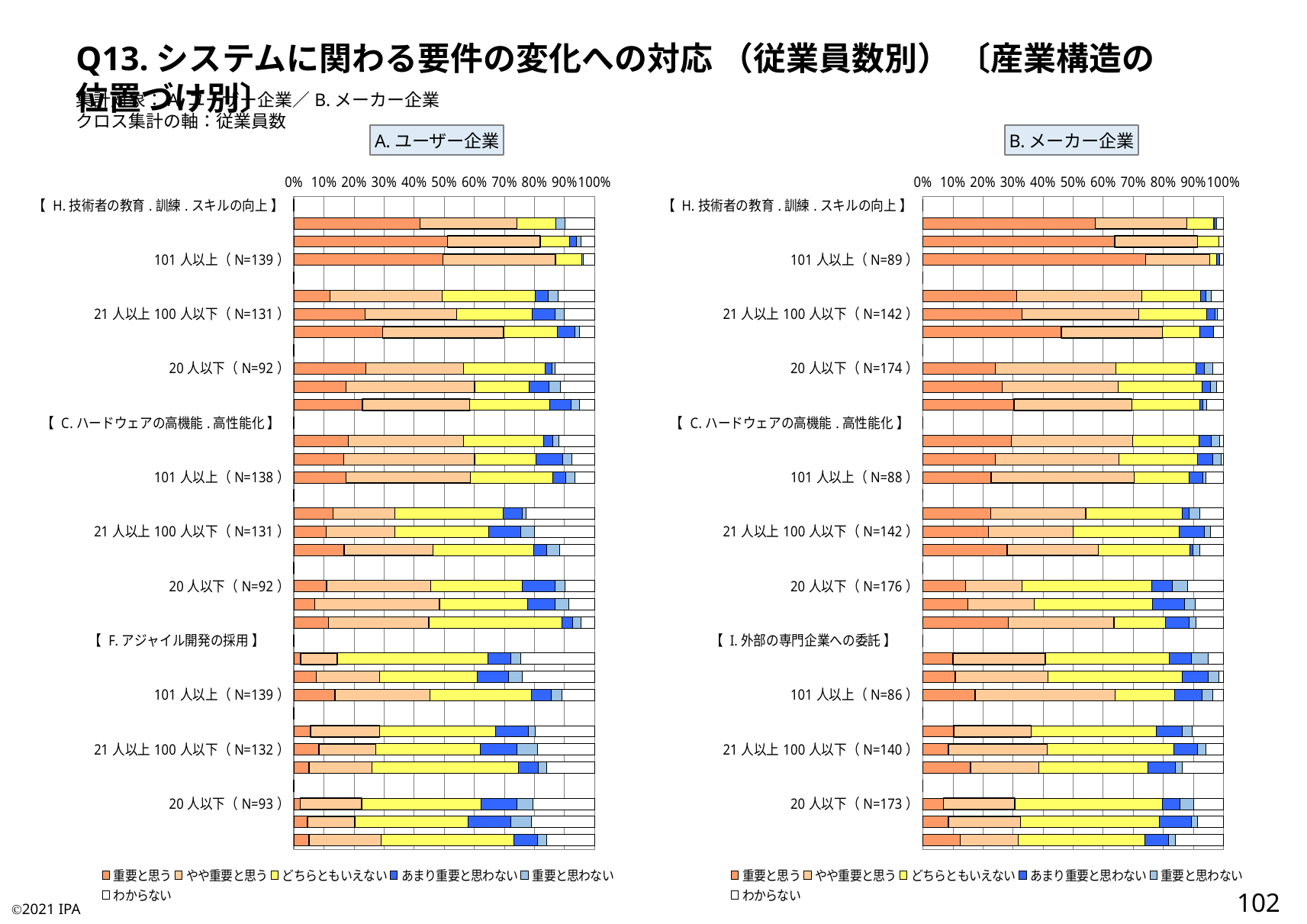
In the B. メーカー企業 chart, is the 重要と思う share for the bar labeled 20 人以下 (N=173) greater or less than 10%? less What is the first legend entry of the A. ユーザー企業 chart? 重要と思う What kind of chart is the A. ユーザー企業 chart on the left? Stacked horizontal bar chart How many bars are plotted in the A. ユーザー企業 chart? 27 In the B. メーカー企業 chart, is the 重要と思う share for the bar labeled 101 人以上 (N=89) greater or less than 60%? greater How many series does the legend of the B. メーカー企業 chart list? 6 In the B. メーカー企業 chart, which bar has the larger 重要と思う share: the one labeled 101 人以上 (N=89) or the one labeled 20 人以下 (N=173)? 101 人以上 (N=89) What is the third section heading on the B. メーカー企業 chart? 【 I. 外部の専門企業への委託 】 In the A. ユーザー企業 chart, is the 重要と思う share for the bar labeled 20 人以下 (N=93) greater or less than 10%? less How many section headings (【 】) are shown on the A. ユーザー企業 chart? 3 What is the maximum value shown on the x axis of the A. ユーザー企業 chart? 100%